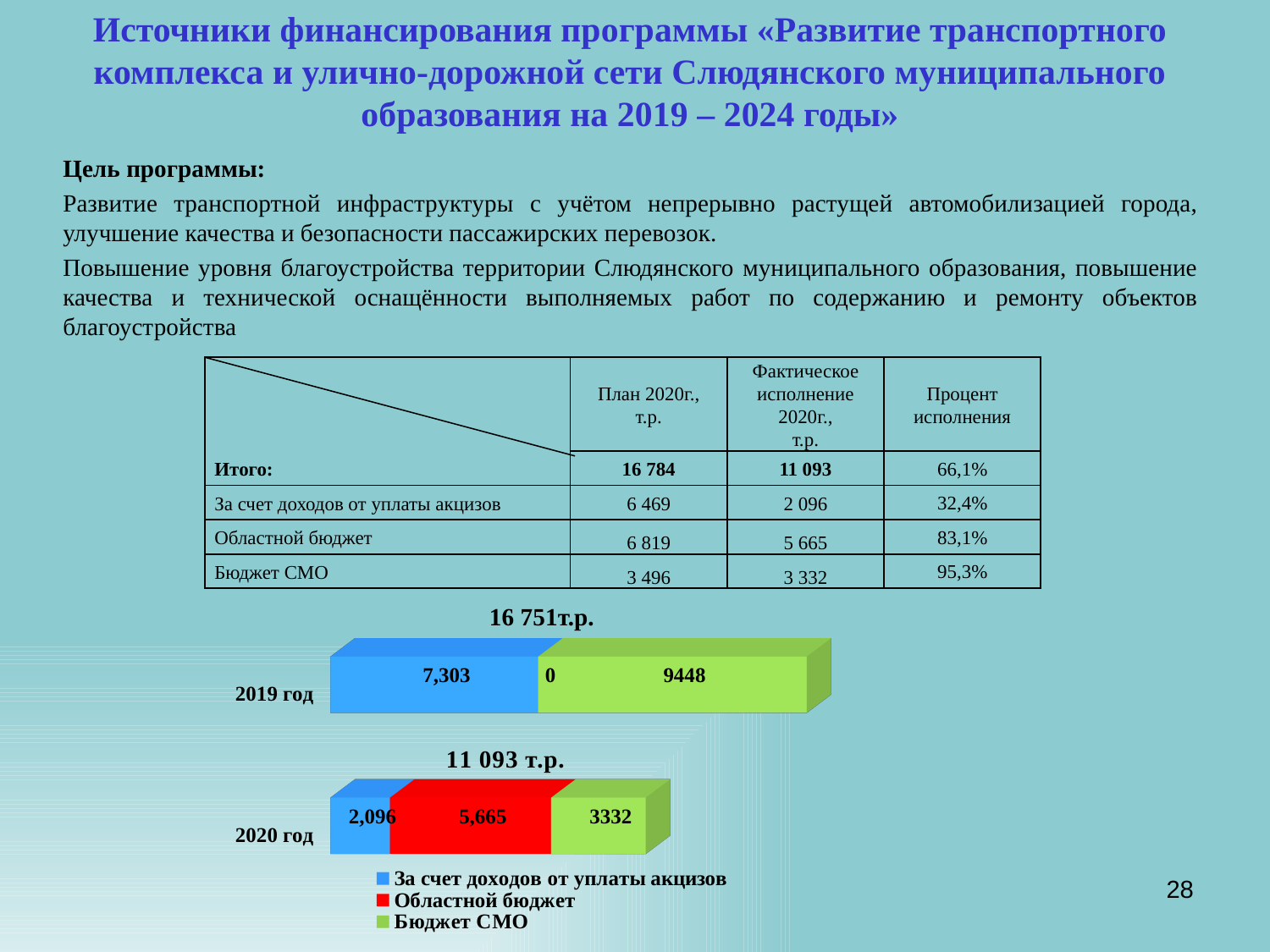
How many series does the chart legend list? 3 How many categories (years) are plotted in the chart? 2 What is the value for «Бюджет СМО» in 2020 год? 3332 What is the total shown for the 2019 год stacked bar? 16 751т.р. Which is larger in 2019 год: «За счет доходов от уплаты акцизов» or «Бюджет СМО»? Бюджет СМО What is the value for «Областной бюджет» in 2019 год? 0 What is the value for «Бюджет СМО» in 2019 год? 9448 Which series has the largest value in 2020 год? Областной бюджет What is the total shown for the 2020 год stacked bar? 11 093 т.р. What is the value for «Областной бюджет» in 2020 год? 5,665 What is the value for «За счет доходов от уплаты акцизов» in 2019 год? 7,303 What kind of chart is shown on the slide? bar chart